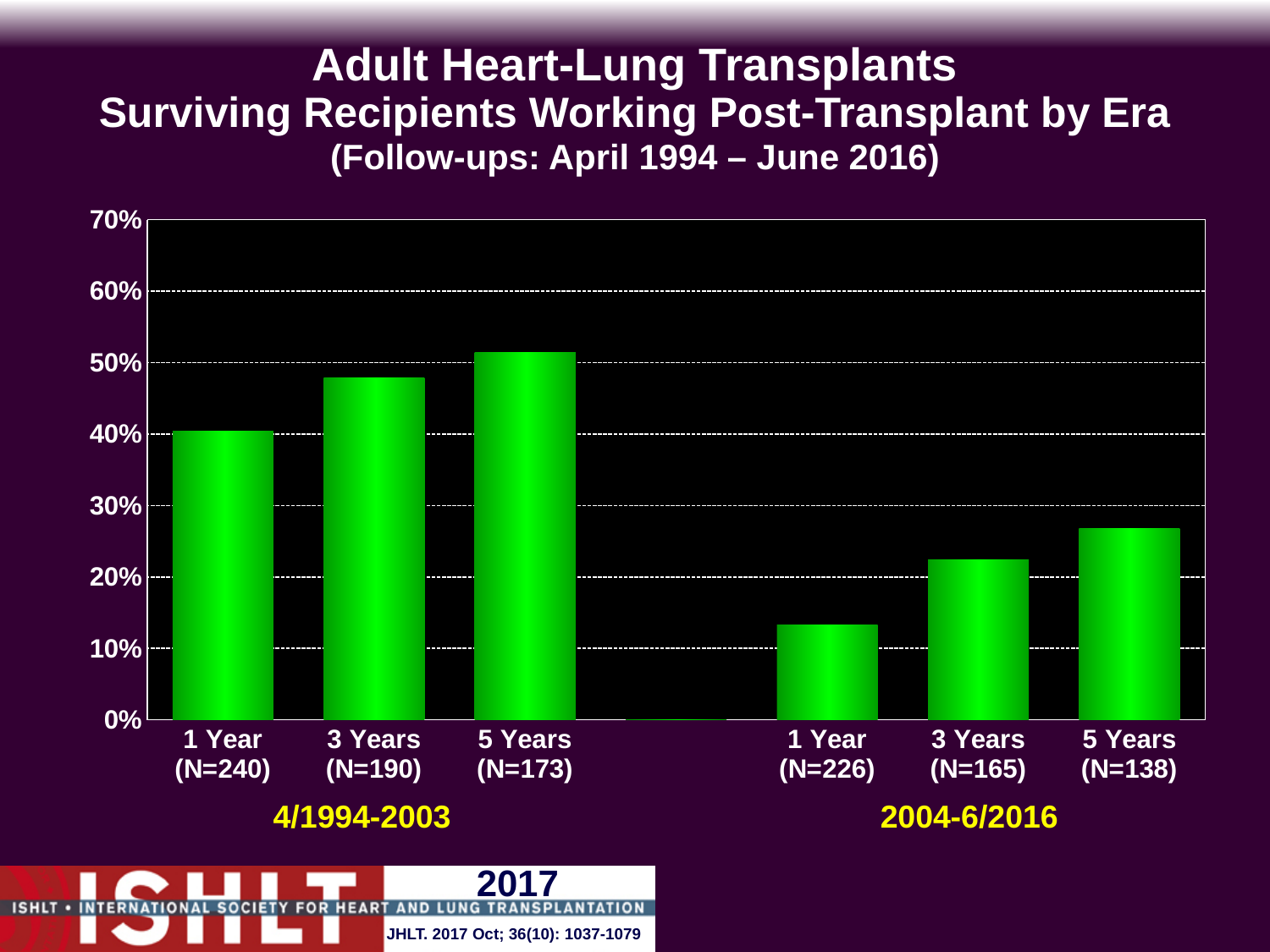
Which bar is the highest in the chart? 5 Years (N=173) in the 4/1994-2003 era How many labeled bars are shown in the chart? 6 What are the two eras labeled beneath the x axis? 4/1994-2003 and 2004-6/2016 Is the value for 1 Year (N=226) in the 2004-6/2016 era greater or less than 20%? less What is the maximum value shown on the y axis? 70% Which is larger: the value for 3 Years (N=190) in the 4/1994-2003 era or the value for 3 Years (N=165) in the 2004-6/2016 era? 3 Years (N=190) in the 4/1994-2003 era Is the value for 5 Years (N=138) in the 2004-6/2016 era greater or less than 30%? less Is the value for 5 Years (N=173) in the 4/1994-2003 era greater or less than 50%? greater Which bar is the lowest in the chart? 1 Year (N=226) in the 2004-6/2016 era Within the 2004-6/2016 era, do the values rise or fall from 1 Year to 5 Years? rise What kind of chart is shown on the slide? bar chart